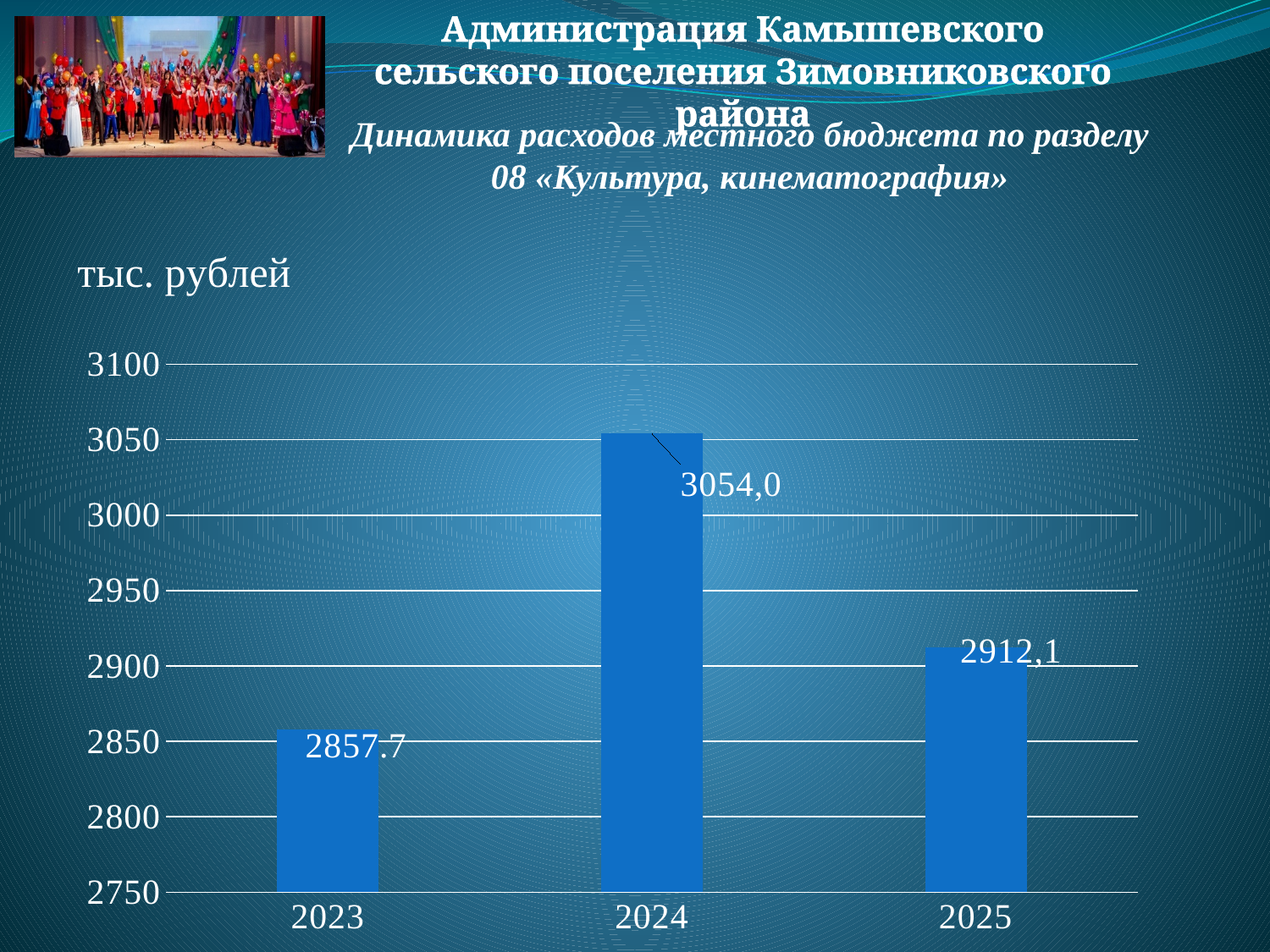
Does the value rise or fall from 2024 to 2025? fall Is the value for 2024 greater or less than 3000? greater Which year has the lowest value in the chart? 2023 What kind of chart is shown on the slide? bar chart What is the value for 2024 in the chart? 3054,0 What is the value for 2023 in the chart? 2857.7 What is the value for 2025 in the chart? 2912,1 Which year has the highest value in the chart? 2024 Which is larger, the value for 2025 or the value for 2023? 2025 Is the value for 2023 greater or less than 2900? less What is the difference between the values for 2024 and 2025? 141,9 How many years are shown on the x axis of the chart? 3